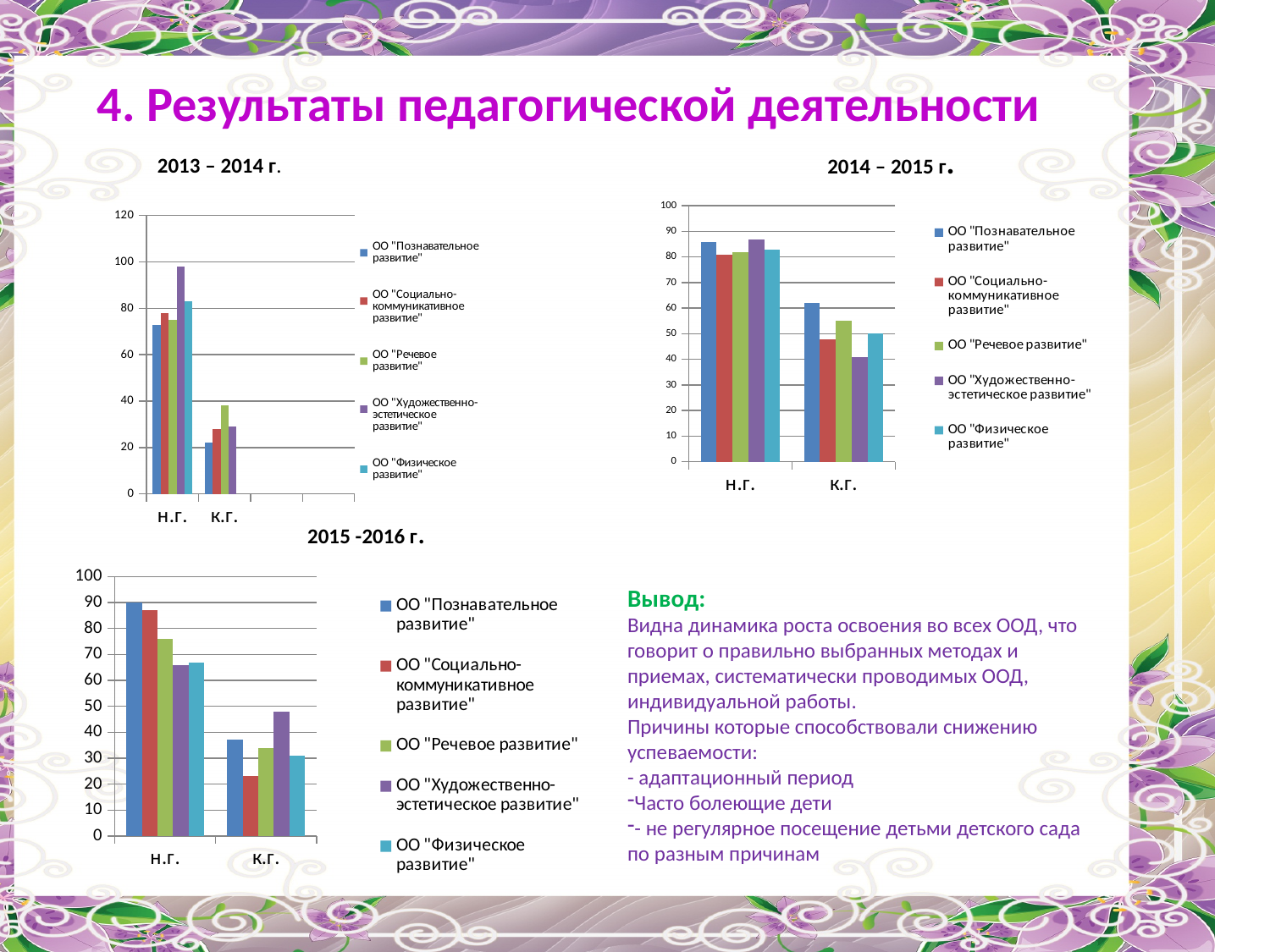
In the "2013 – 2014 г." chart, which series has the highest value at Н.Г.? ОО "Художественно-эстетическое развитие" What kind of chart is the "2013 – 2014 г." chart? bar chart In the "2015 -2016 г." chart, which series has the highest value at К.Г.? ОО "Художественно-эстетическое развитие" In the "2013 – 2014 г." chart, is the value for ОО "Художественно-эстетическое развитие" at Н.Г. greater or less than 80? greater What is the title of the chart at the bottom left of the slide? 2015 -2016 г. How many categories are shown on the x axis of the "2014 – 2015 г." chart? 2 In the "2014 – 2015 г." chart, does the value for ОО "Познавательное развитие" rise or fall from Н.Г. to К.Г.? fall In the "2014 – 2015 г." chart, at К.Г., which is larger: ОО "Познавательное развитие" or ОО "Художественно-эстетическое развитие"? ОО "Познавательное развитие" In the "2015 -2016 г." chart, is the value for ОО "Социально-коммуникативное развитие" at К.Г. greater or less than 30? less In the "2014 – 2015 г." chart, is the value for ОО "Познавательное развитие" at К.Г. greater or less than 50? greater How many series does the legend of the "2015 -2016 г." chart list? 5 In the "2015 -2016 г." chart, which series has the lowest value at К.Г.? ОО "Социально-коммуникативное развитие"